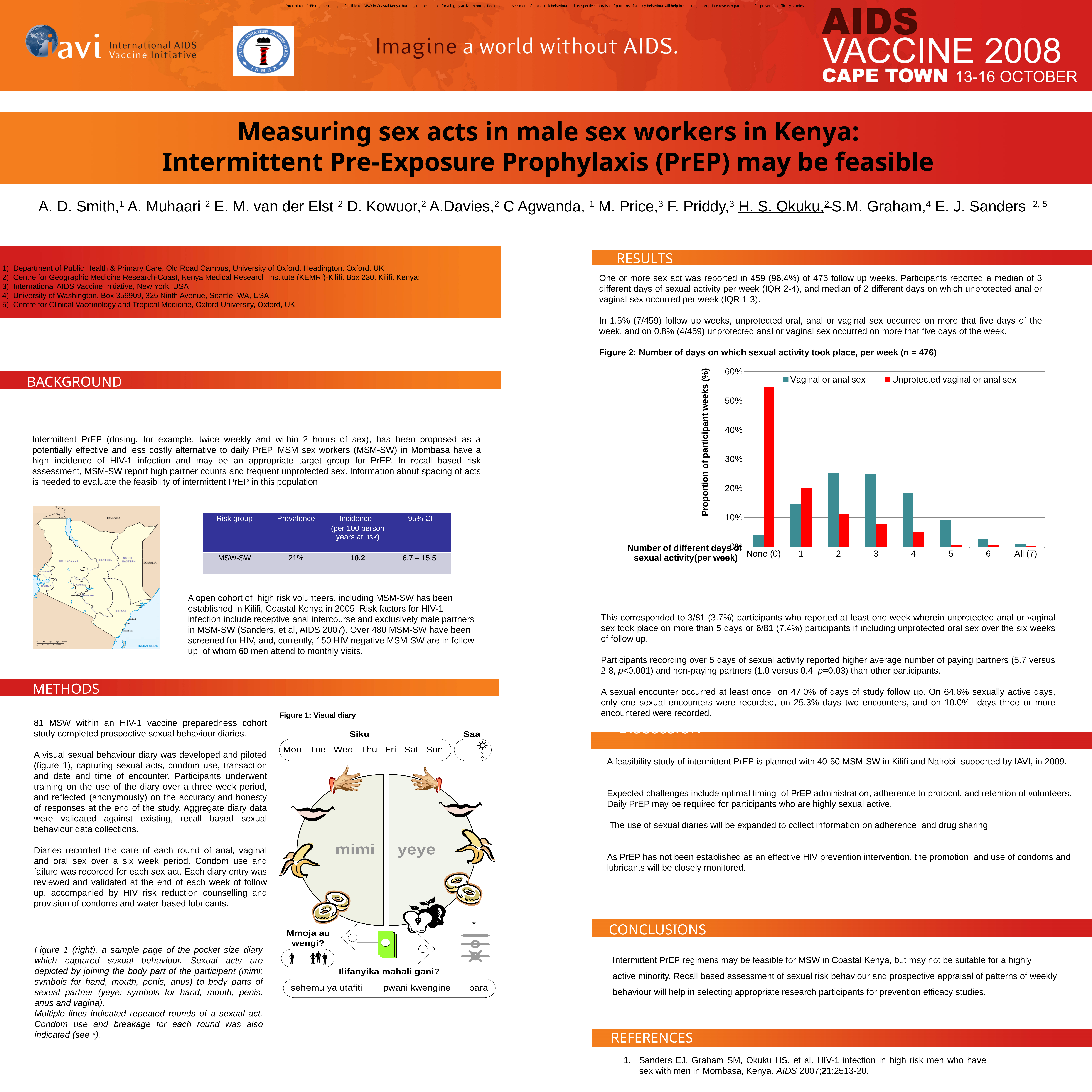
In Figure 2, which category has the highest value for the Unprotected vaginal or anal sex series? None (0) In Figure 2, at 2 days, which series has the larger value: Vaginal or anal sex or Unprotected vaginal or anal sex? Vaginal or anal sex How many categories are shown on the x axis of Figure 2? 8 What kind of chart is Figure 2? bar chart In Figure 2, do the values for Unprotected vaginal or anal sex rise or fall from None (0) to All (7)? fall In Figure 2, is the value for Vaginal or anal sex at 2 days greater or less than 20%? greater How many series does the legend of Figure 2 list? 2 In Figure 2, at None (0), which series has the larger value: Vaginal or anal sex or Unprotected vaginal or anal sex? Unprotected vaginal or anal sex In Figure 2, is the value for Unprotected vaginal or anal sex at 3 days greater or less than 10%? less In Figure 2, is the value for Unprotected vaginal or anal sex at None (0) greater or less than 50%? greater What is the y-axis label of Figure 2? Proportion of participant weeks (%)